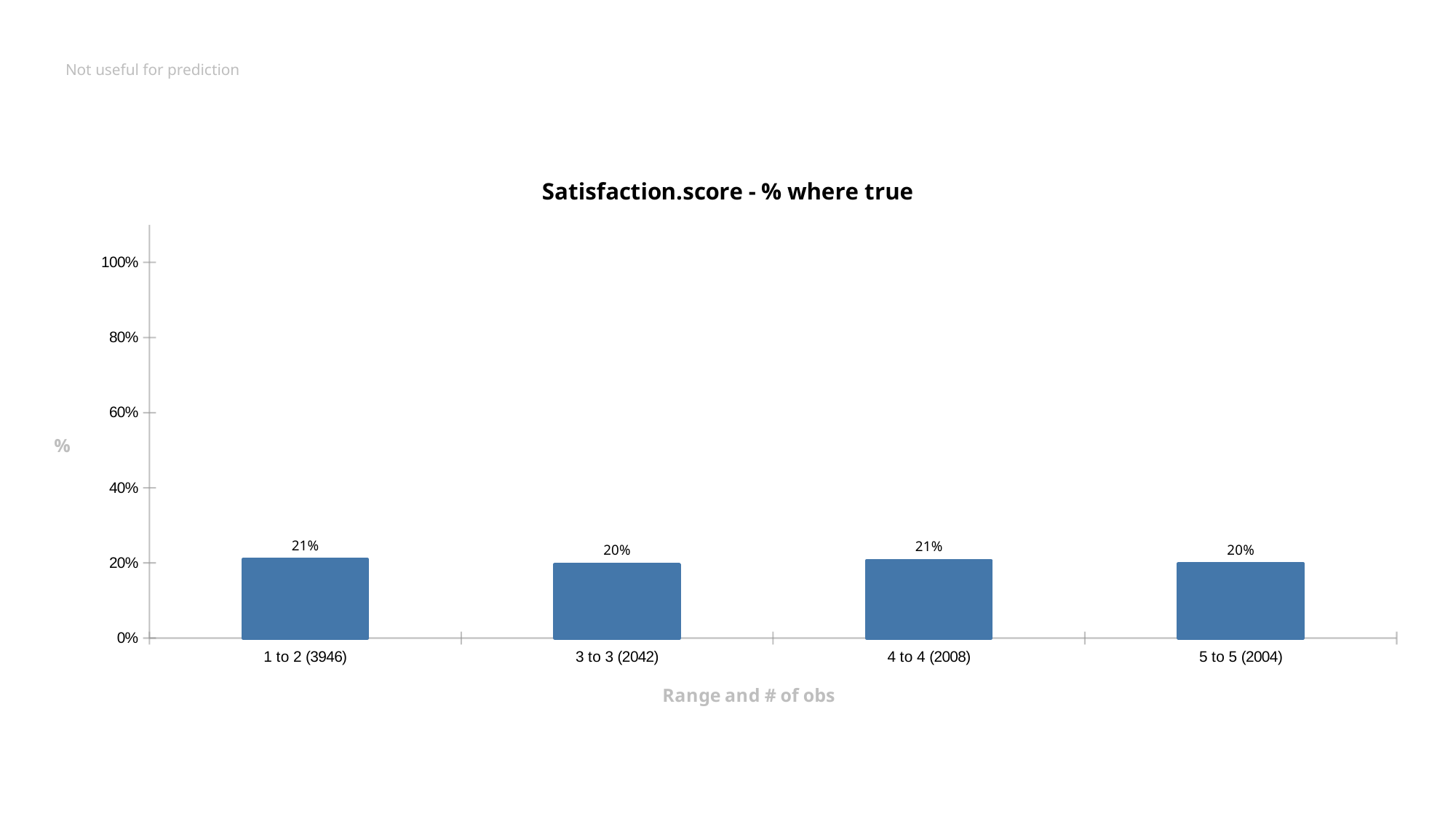
What is the value for the category "5 to 5 (2004)"? 20% What is the value for the category "3 to 3 (2042)"? 20% What is the value for the category "4 to 4 (2008)"? 21% Is the value for "1 to 2 (3946)" greater or less than 40%? less Is the value for "5 to 5 (2004)" greater or less than 60%? less What is the difference between the values for "4 to 4 (2008)" and "5 to 5 (2004)"? 1% What is the value for the category "1 to 2 (3946)"? 21% How many categories are plotted on the x axis? 4 What is the title of the chart? Satisfaction.score - % where true Which has the larger value, "1 to 2 (3946)" or "3 to 3 (2042)"? 1 to 2 (3946) What type of chart is shown on the slide? bar chart What is the x axis title of the chart? Range and # of obs